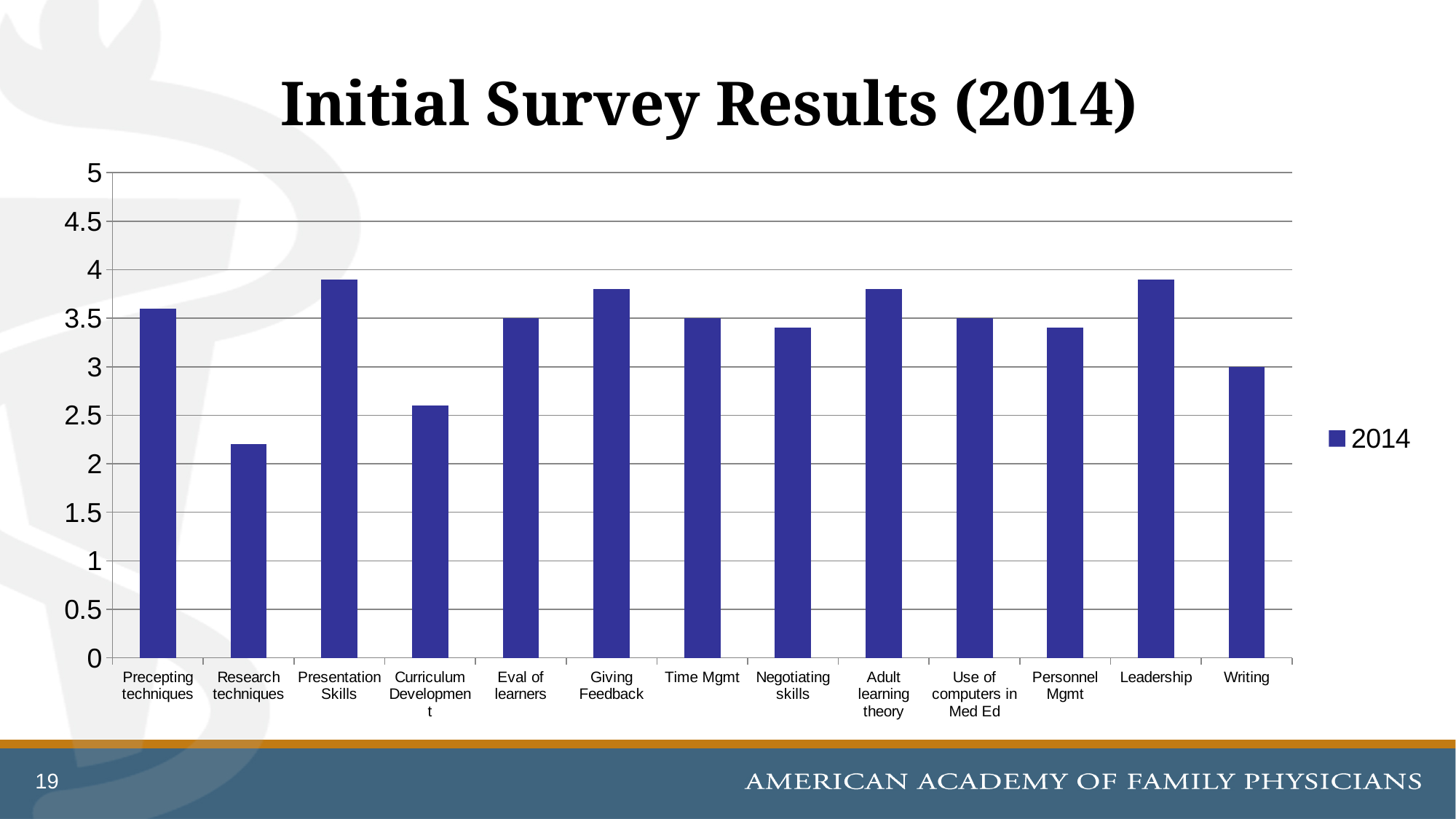
Which is larger, the value for Research techniques or the value for Curriculum Development? Curriculum Development Is the value for Giving Feedback greater or less than 4? less What kind of chart is shown on the slide? bar chart What is the value for Eval of learners? 3.5 What is the title of the chart? Initial Survey Results (2014) Which category has the lowest value? Research techniques How many series does the legend list? 1 Is the value for Research techniques greater or less than 2.5? less What is the value for Time Mgmt? 3.5 How many categories are plotted along the x axis? 13 Is the value for Curriculum Development greater or less than 3? less What is the value for Writing? 3